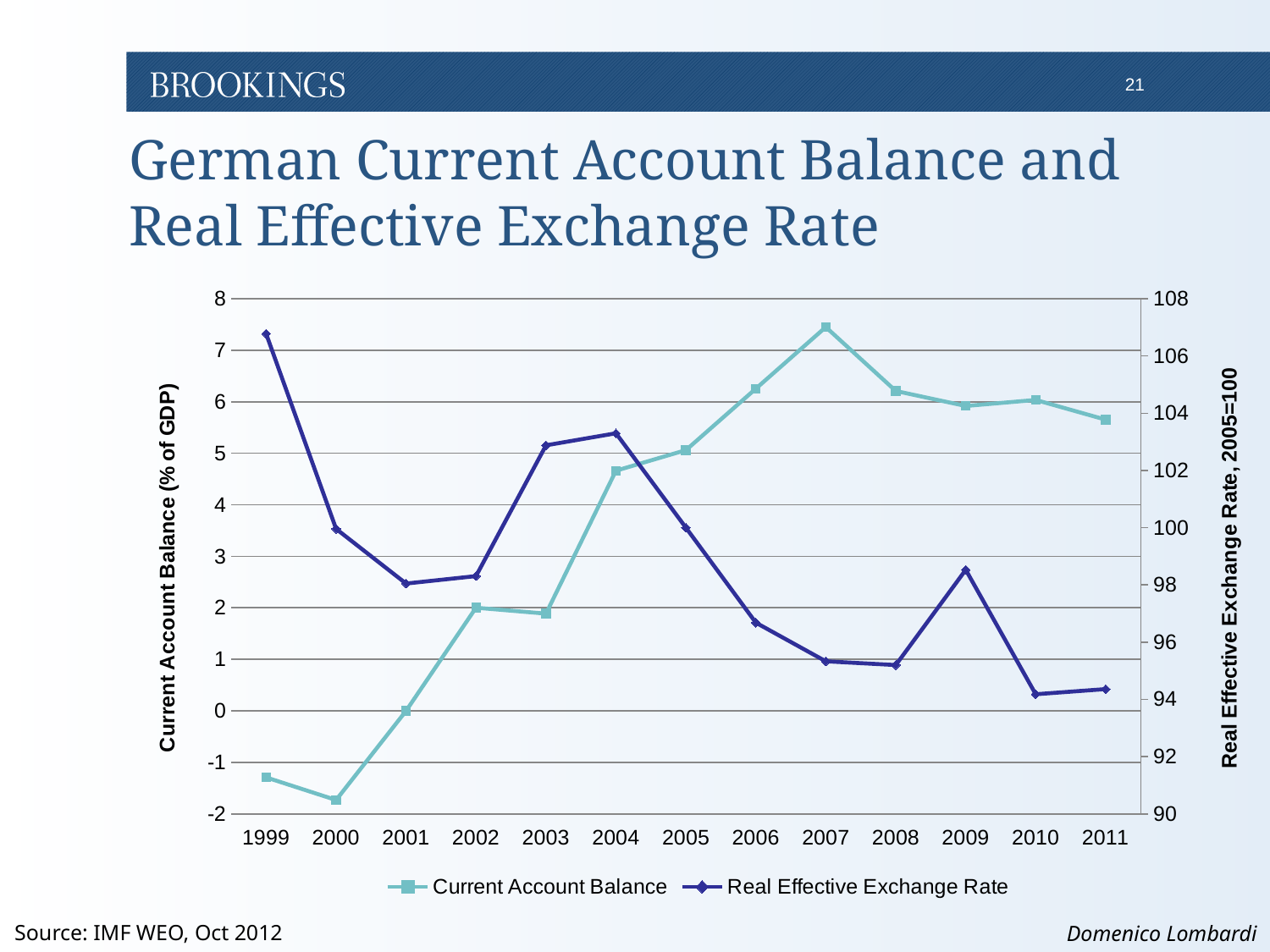
What kind of chart is shown on the slide? Line chart In which year is the Current Account Balance highest? 2007 Is the Current Account Balance in 2007 greater or less than 7? greater Is the Real Effective Exchange Rate in 1999 greater or less than 106? greater Is the Real Effective Exchange Rate in 2007 greater or less than 96? less How many series does the legend list? 2 In which year is the Real Effective Exchange Rate highest? 1999 Does the Current Account Balance rise or fall from 1999 to 2007? Rise What is the label of the right-hand vertical axis? Real Effective Exchange Rate, 2005=100 How many years are plotted along the x axis? 13 In which year is the Current Account Balance lowest? 2000 Which is larger, the Current Account Balance in 2006 or in 2011? 2006